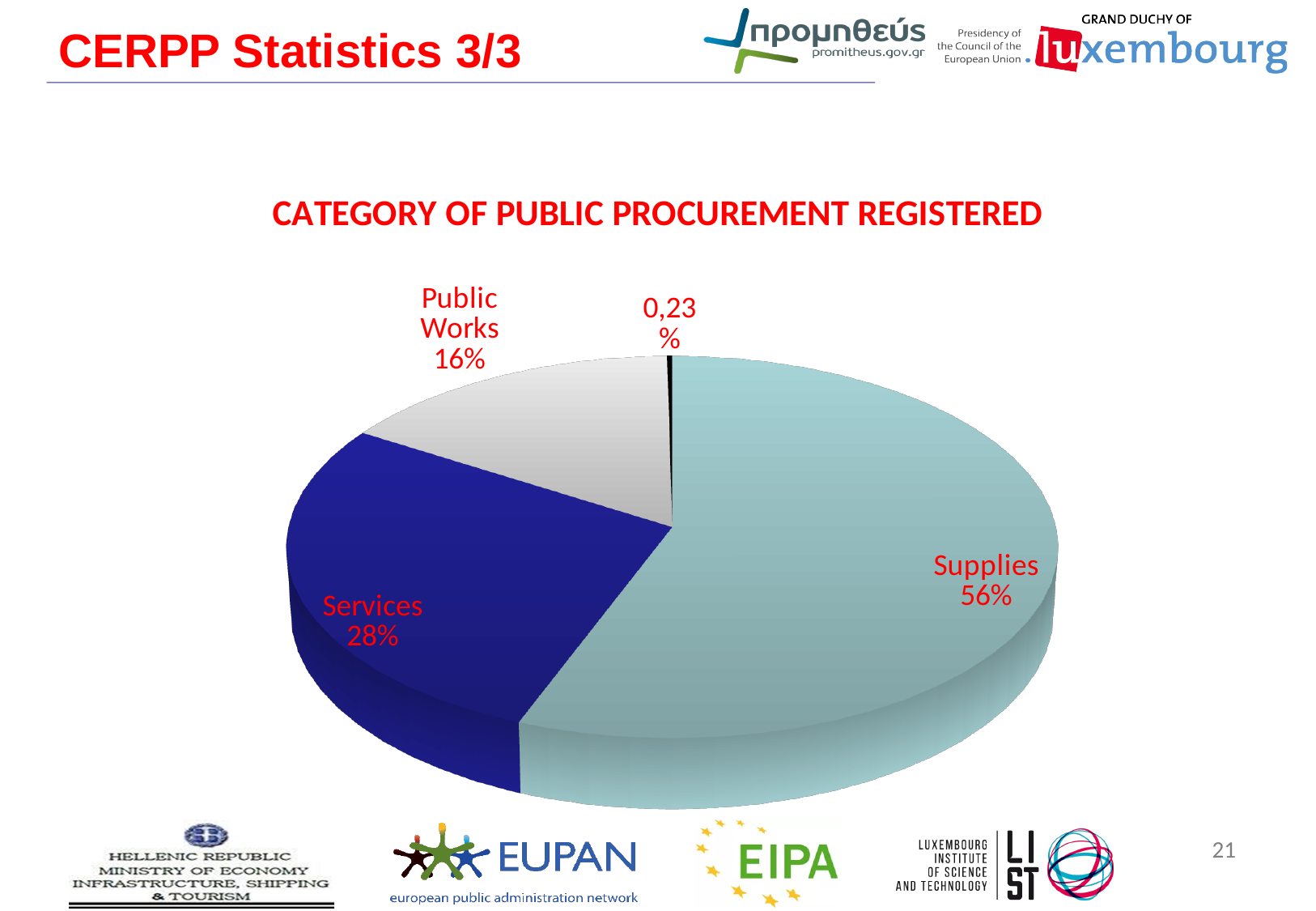
Which category has the largest slice of the pie? Supplies What colour is the Services slice? Dark blue What is the title of the chart? CATEGORY OF PUBLIC PROCUREMENT REGISTERED What is the difference in percentage points between Supplies and Services? 28 What is the difference in percentage points between Services and Public Works? 12 What percentage is shown for Services? 28% What share of the pie does Supplies account for? 56% What is the smallest percentage value labelled on the pie chart? 0,23% What kind of chart is shown on the slide? Pie chart Which is larger, the share for Services or the share for Public Works? Services What percentage is shown for Public Works? 16% How many slices does the pie chart have? 4